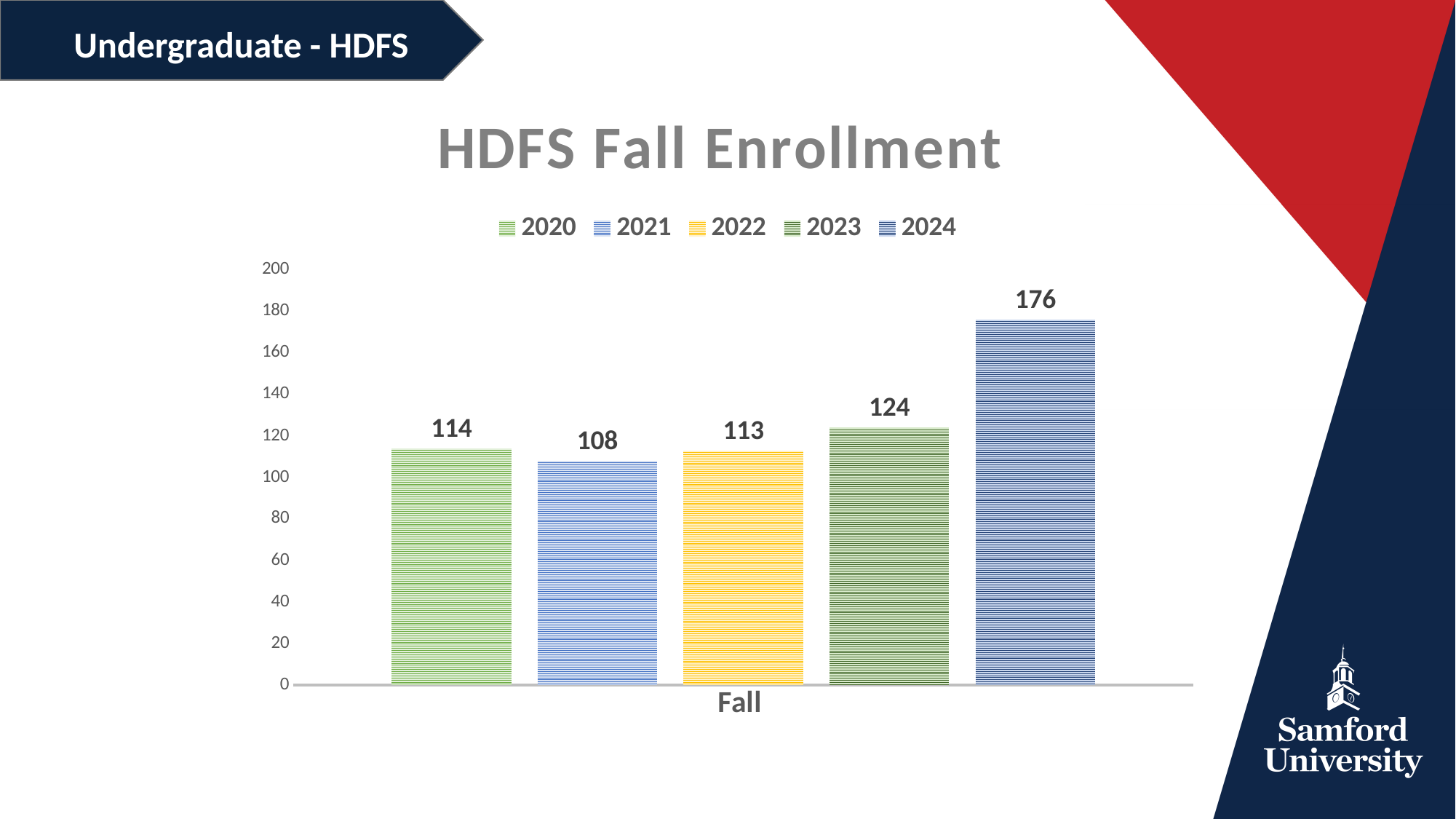
Is the HDFS fall enrollment for 2024 greater or less than 160? greater How many series does the legend list? 5 Which year has the highest HDFS fall enrollment? 2024 What is the HDFS fall enrollment for 2020? 114 Which is larger, the HDFS fall enrollment for 2023 or for 2022? 2023 What is the title of the chart? HDFS Fall Enrollment What kind of chart is shown on the slide? bar chart What is the difference in HDFS fall enrollment between 2020 and 2021? 6 Which year has the lowest HDFS fall enrollment? 2021 What is the difference in HDFS fall enrollment between 2024 and 2023? 52 What is the HDFS fall enrollment for 2024? 176 What is the HDFS fall enrollment for 2022? 113